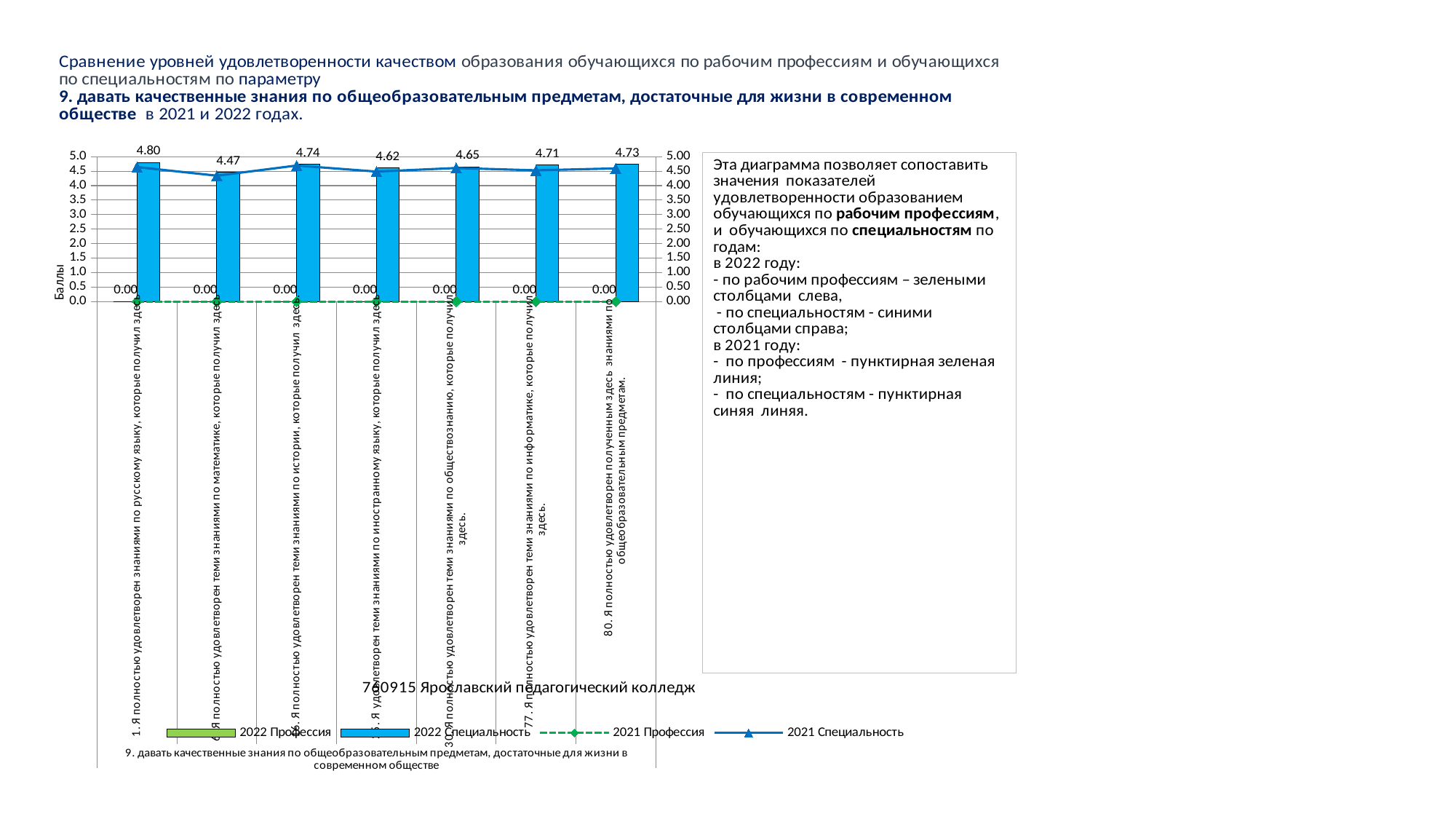
Is the 2022 Специальность value for the category about обществознание greater or less than 4.0? greater What is the 2022 Специальность value for the category about знания по русскому языку? 4.80 How many categories are shown on the x axis of the chart? 7 What is the 2022 Профессия value shown for the category about знания по русскому языку? 0.00 What is the difference between the highest (русский язык) and lowest (математика) 2022 Специальность values? 0.33 Which category has the highest 2022 Специальность value? 1. Я полностью удовлетворен знаниями по русскому языку, которые получил здесь Which category has the lowest 2022 Специальность value? Я полностью удовлетворен теми знаниями по математике, которые получил здесь What is the 2022 Специальность value for the category about знания по информатике? 4.71 How many series does the chart legend list? 4 What is the label of the vertical axis on the left of the chart? Баллы What is the 2022 Специальность value for the category about знания по математике? 4.47 Which has a larger 2022 Специальность value: the category about история or the category about иностранный язык? история